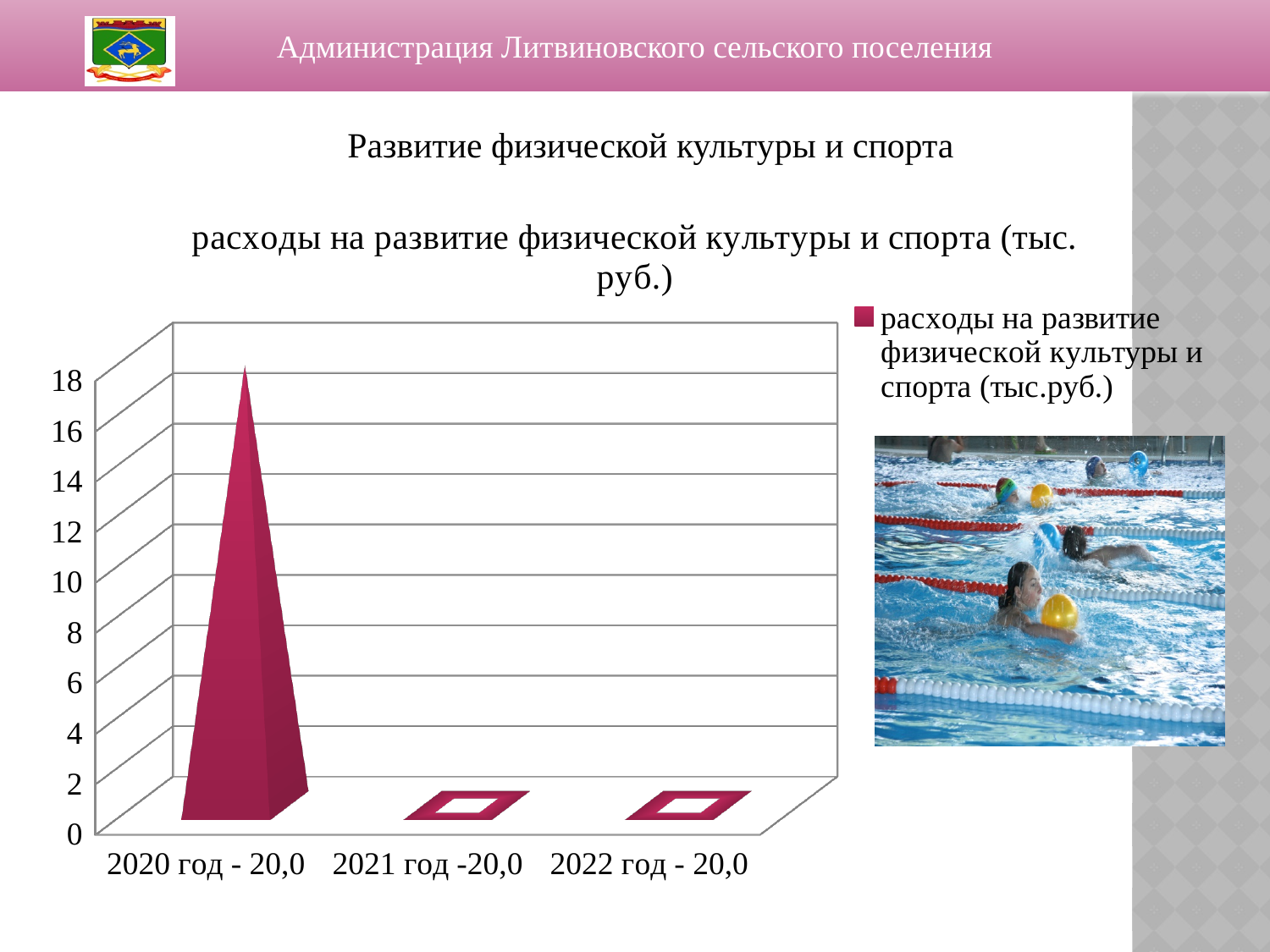
Is the value for 2020 год - 20,0 greater or less than 10? greater What kind of chart is shown on the slide? bar chart What is the title of the chart? расходы на развитие физической культуры и спорта (тыс. руб.) Is the value for 2022 год - 20,0 greater or less than 4? less Which category has the highest value in the chart? 2020 год - 20,0 How many series does the chart legend list? 1 What is the highest tick value shown on the vertical axis of the chart? 18 How many categories are shown on the x axis of the chart? 3 Which is larger, the value for 2020 год - 20,0 or the value for 2021 год -20,0? 2020 год - 20,0 Is the value for 2021 год -20,0 greater or less than 2? less Do the values rise or fall from 2020 год - 20,0 to 2021 год -20,0? fall